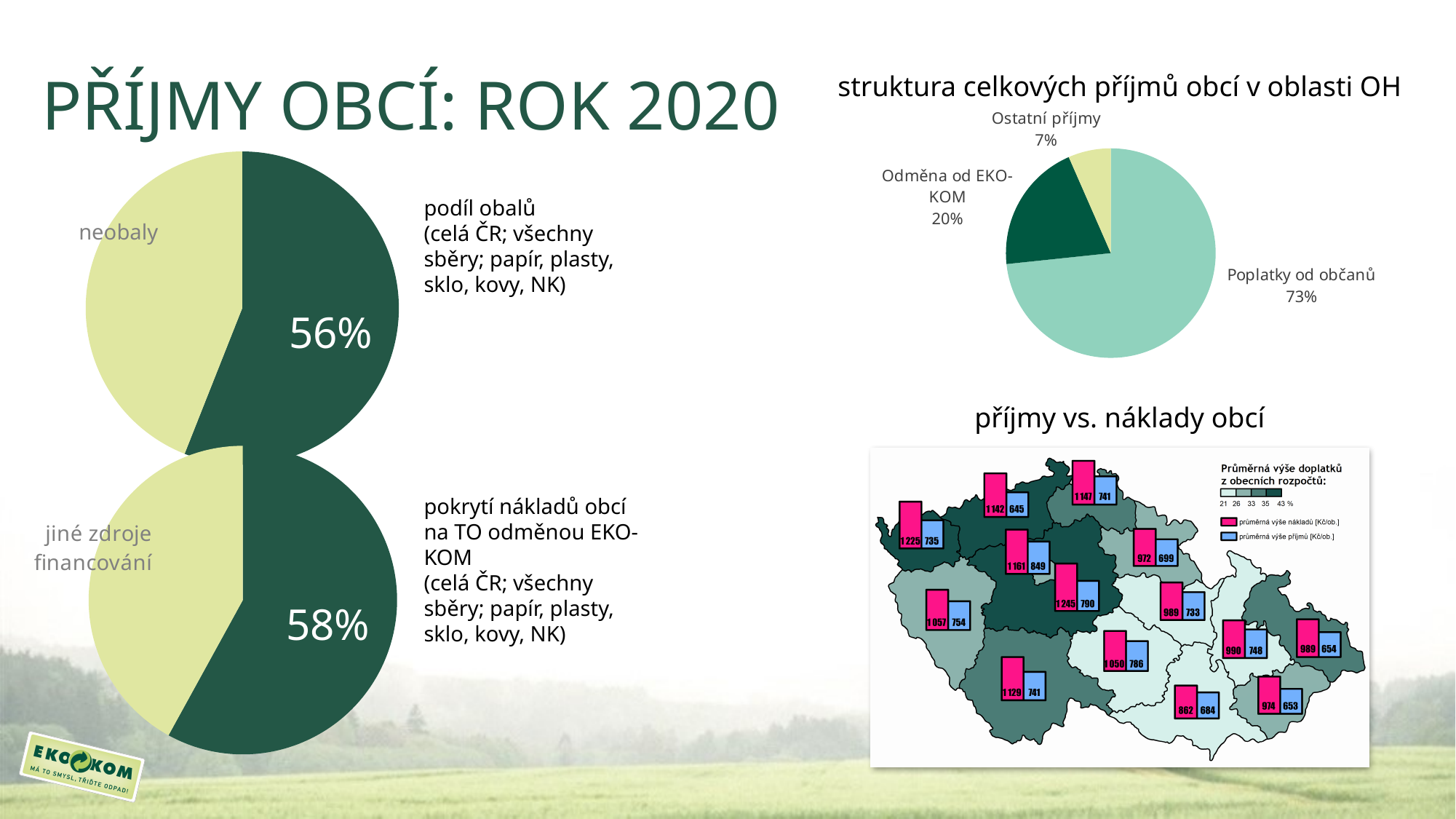
In the map 'příjmy vs. náklady obcí', what is the highest value shown for průměrná výše nákladů (pink bars)? 1 245 In the pie chart 'struktura celkových příjmů obcí v oblasti OH', what share is Poplatky od občanů? 73% In the pie chart 'struktura celkových příjmů obcí v oblasti OH', how many percentage points larger is Poplatky od občanů than Odměna od EKO-KOM? 53 percentage points What type of chart is 'struktura celkových příjmů obcí v oblasti OH'? pie chart How many slices does the pie chart 'struktura celkových příjmů obcí v oblasti OH' have? 3 In the bottom-left pie chart, what percentage is shown for pokrytí nákladů obcí na TO odměnou EKO-KOM? 58% In the pie chart 'struktura celkových příjmů obcí v oblasti OH', which category has the largest share? Poplatky od občanů In the pie chart 'struktura celkových příjmů obcí v oblasti OH', which category has the smallest share? Ostatní příjmy In the top-left pie chart, what percentage is shown for podíl obalů? 56% In the bottom-left pie chart, what is the label of the lighter slice? jiné zdroje financování In the pie chart 'struktura celkových příjmů obcí v oblasti OH', what share is Odměna od EKO-KOM? 20% In the top-left pie chart, which slice is larger: podíl obalů or neobaly? podíl obalů